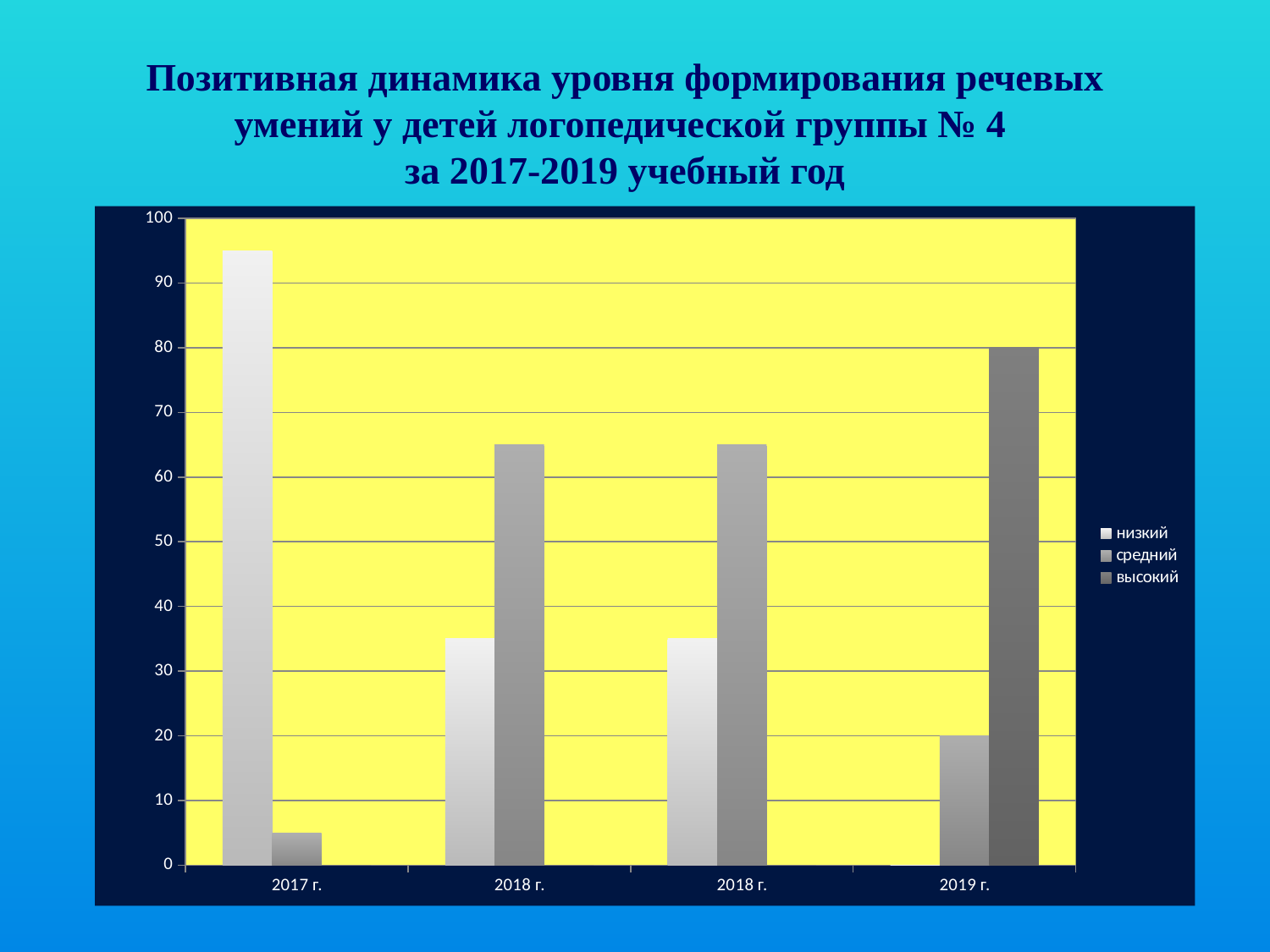
How many series does the legend list? 3 Is the value for средний in 2017 г. greater or less than 10? less What kind of chart is shown on the slide? bar chart How many categories are shown on the x axis? 4 Is the value for средний in the first 2018 г. category greater or less than 60? greater Does the value for низкий rise or fall from 2017 г. to 2019 г.? fall What is the value for средний in 2019 г.? 20 In 2019 г., which is larger: средний or высокий? высокий Which series has the tallest bar in 2017 г.? низкий Is the value for низкий in 2017 г. greater or less than 90? greater What is the value for высокий in 2019 г.? 80